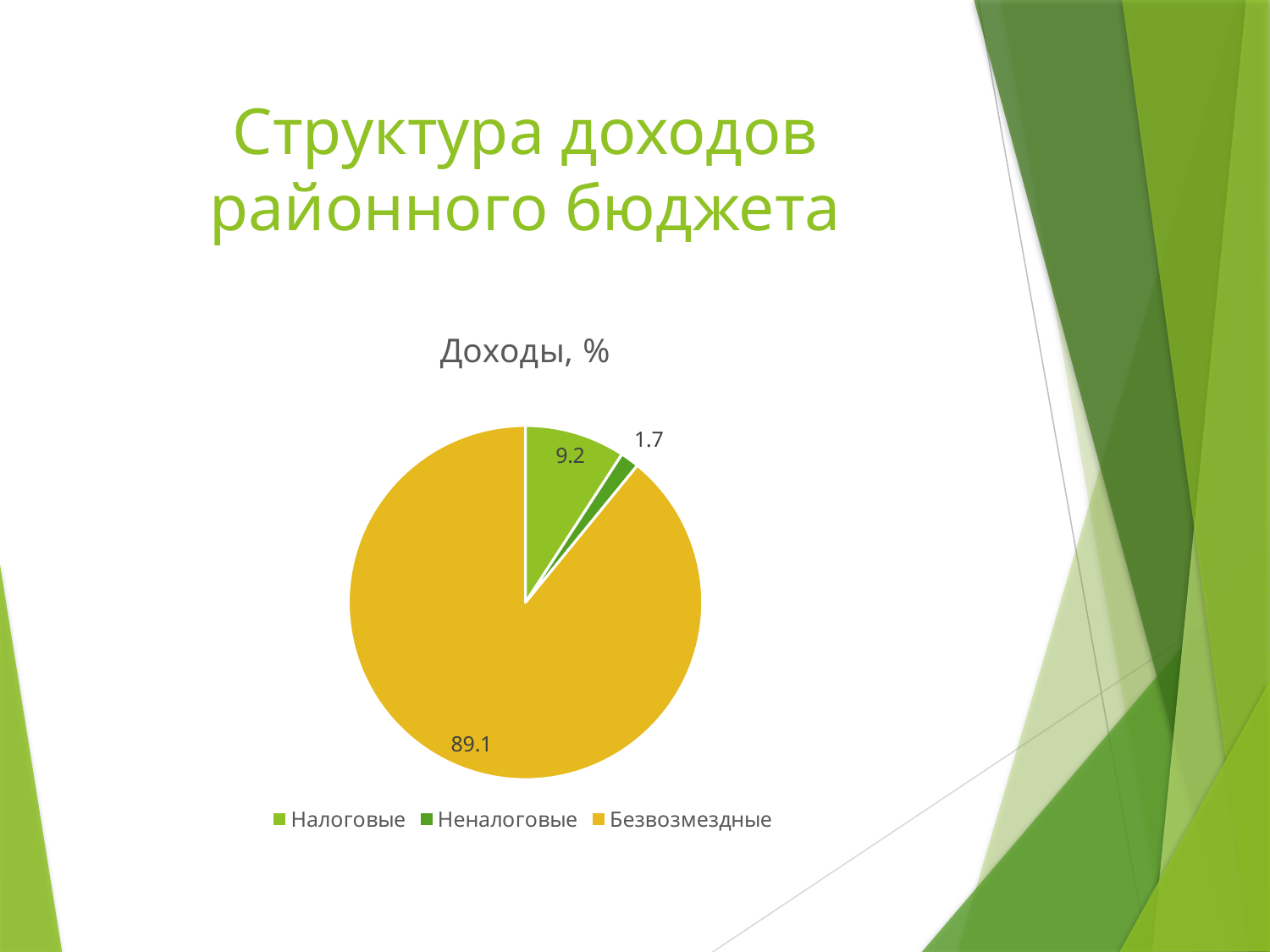
What is the value for Налоговые? 9.2 How many categories does the pie chart have? 3 What is the difference between the values for Безвозмездные and Налоговые? 79.9 Which category has the largest share of the pie? Безвозмездные What is the title of the chart? Доходы, % What is the difference between the values for Налоговые and Неналоговые? 7.5 Which category has the smallest share of the pie? Неналоговые What is the value for Неналоговые? 1.7 What is the value for Безвозмездные? 89.1 Which category is shown in yellow? Безвозмездные What type of chart is shown on the slide? Pie chart Which is larger, Налоговые or Неналоговые? Налоговые